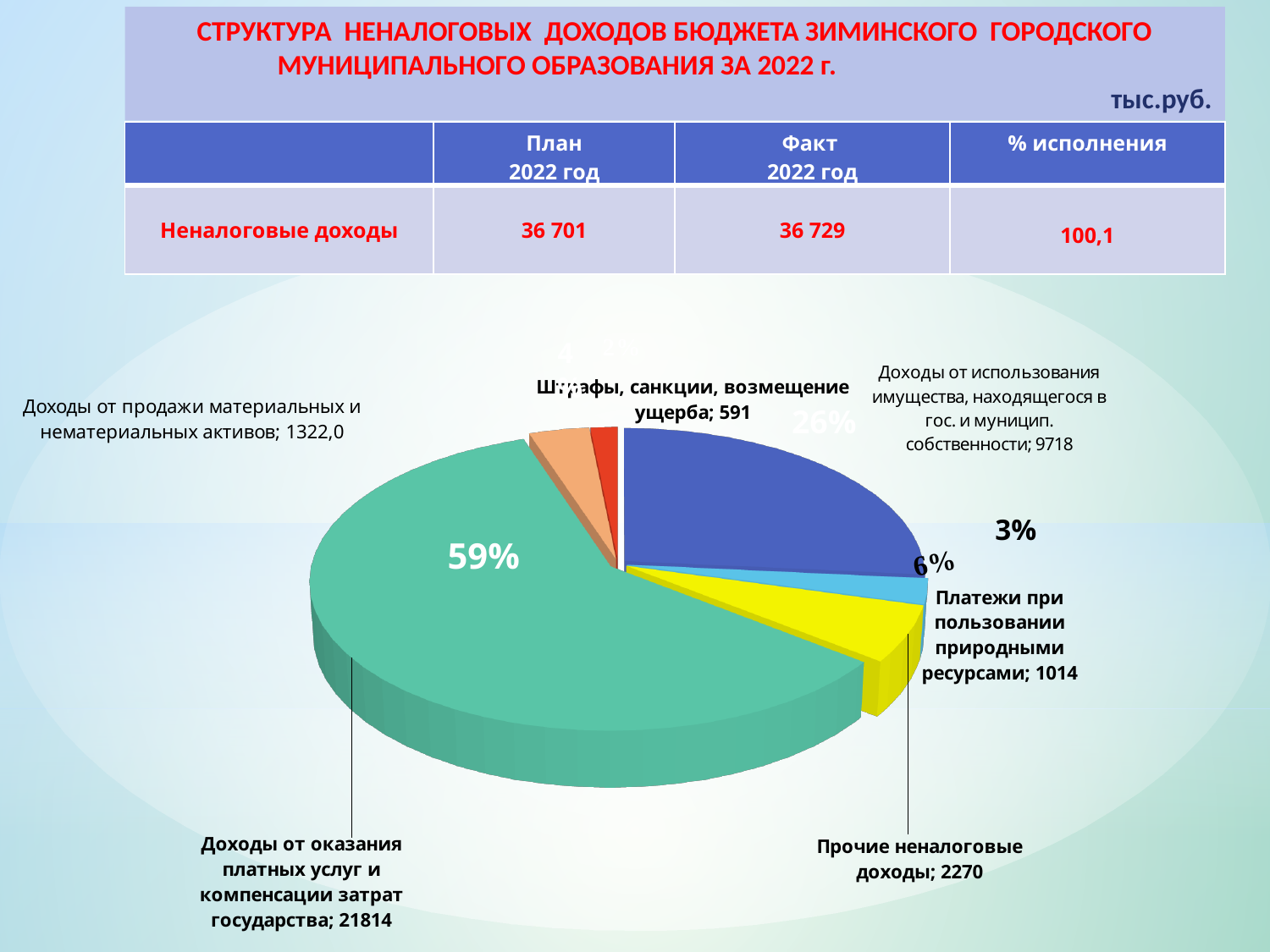
Which category has the smallest slice of the pie? Штрафы, санкции, возмещение ущерба Which category has the largest slice of the pie? Доходы от оказания платных услуг и компенсации затрат государства What is the value for «Платежи при пользовании природными ресурсами»? 1014 What kind of chart is shown on the slide? Pie chart What is the value for «Прочие неналоговые доходы»? 2270 What is the value for «Доходы от оказания платных услуг и компенсации затрат государства»? 21814 What is the value for «Штрафы, санкции, возмещение ущерба»? 591 How many categories (slices) does the pie chart show? 6 Which is larger: «Прочие неналоговые доходы» or «Платежи при пользовании природными ресурсами»? Прочие неналоговые доходы What share of the pie does «Доходы от оказания платных услуг и компенсации затрат государства» represent? 59% What is the value for «Доходы от использования имущества, находящегося в гос. и муницип. собственности»? 9718 What is the difference between «Доходы от оказания платных услуг и компенсации затрат государства» and «Доходы от использования имущества, находящегося в гос. и муницип. собственности»? 12096